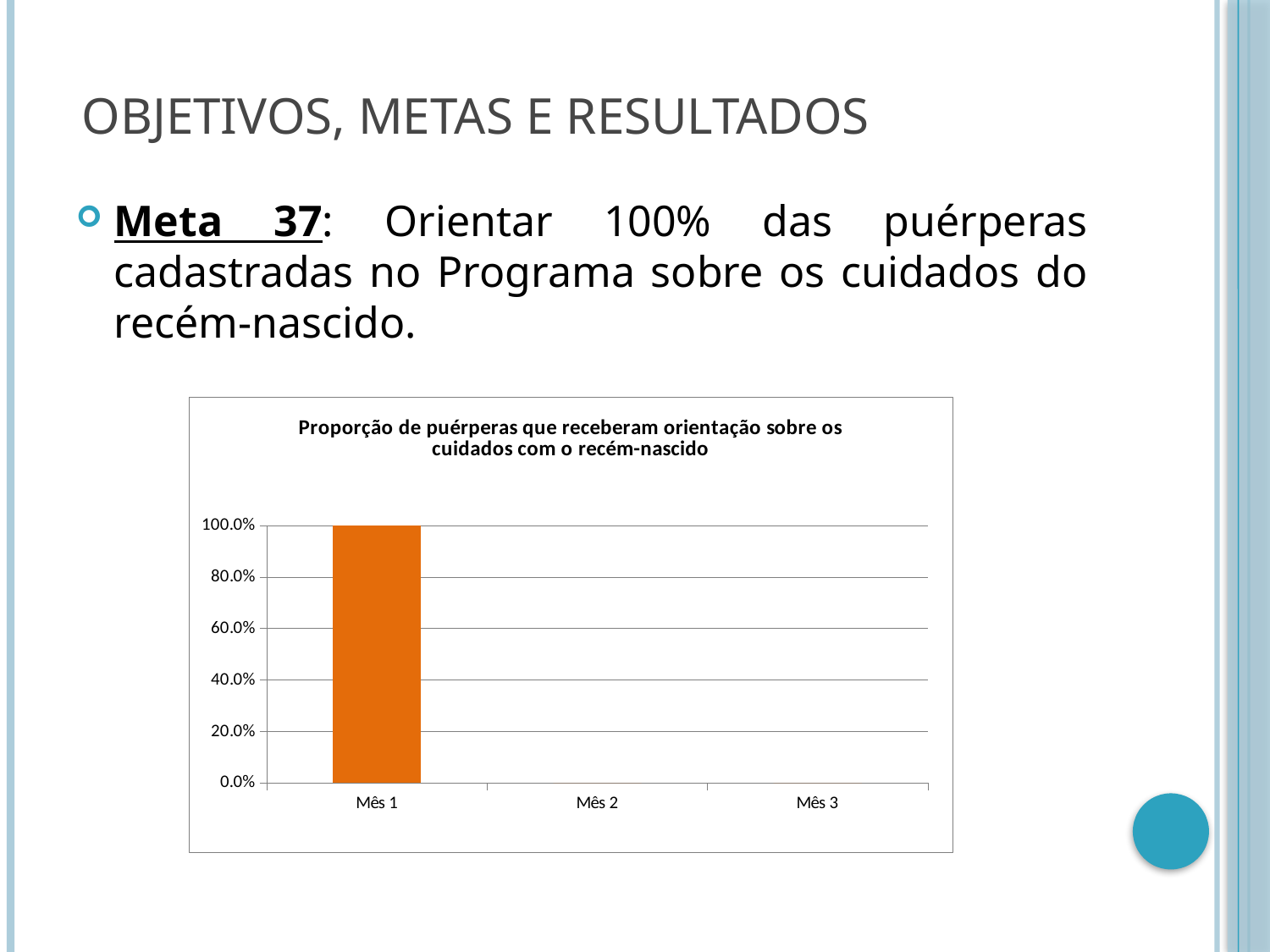
How many categories are shown on the x axis of the chart? 3 Which category is labelled furthest to the right on the x axis? Mês 3 What colour is the bar for Mês 1? orange What is the value for Mês 1 in the chart? 100.0% Which category has the highest value in the chart? Mês 1 What is the highest value shown on the y axis of the chart? 100.0% What type of chart is shown on the slide? bar chart Is the value for Mês 1 greater or less than 80.0%? greater Is the value for Mês 1 greater or less than 60.0%? greater